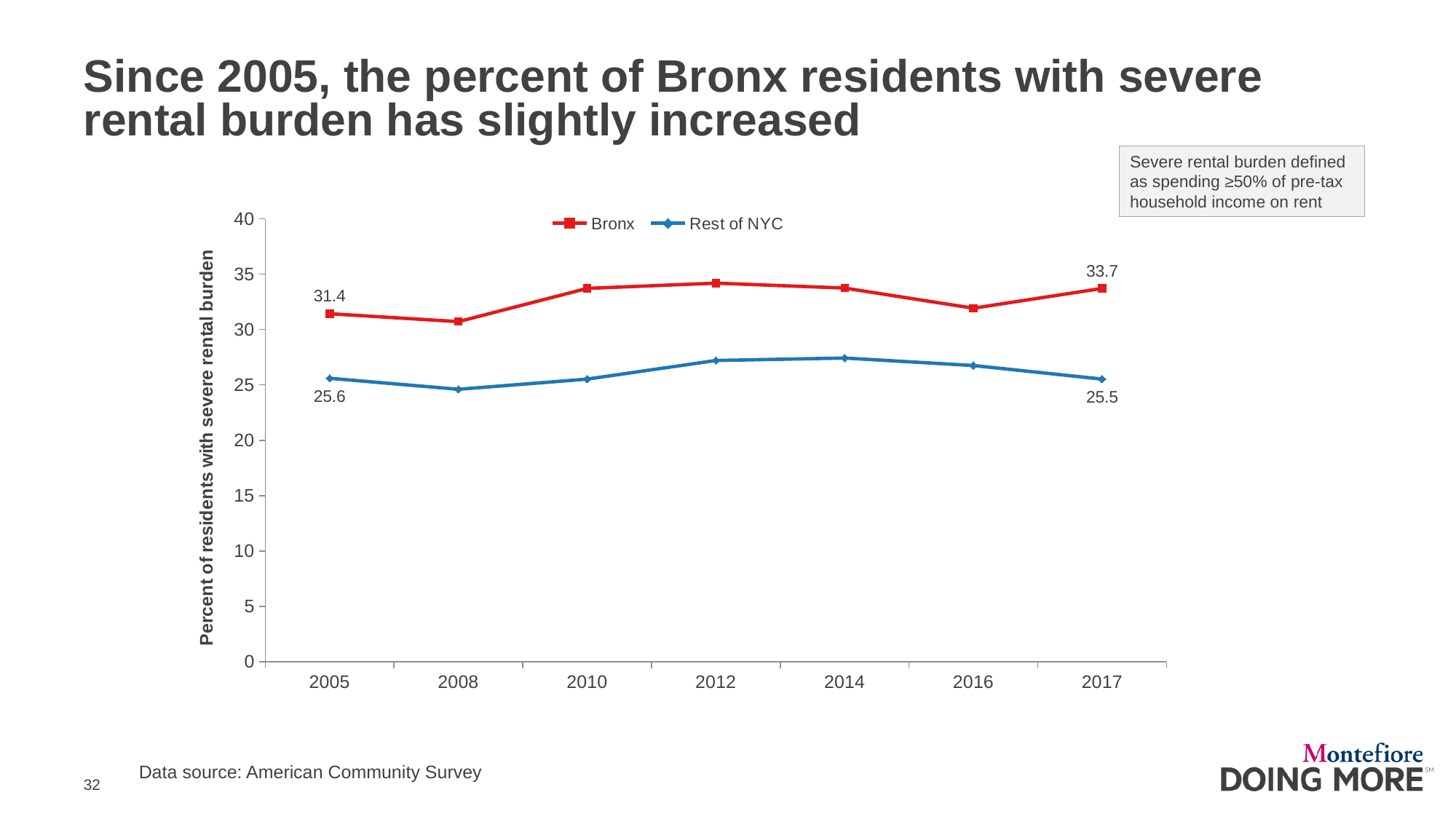
What is the difference between the Bronx and Rest of NYC values in 2017? 8.2 Which series has the higher value in 2012, Bronx or Rest of NYC? Bronx How many years are shown on the x axis? 7 What is the value for Bronx in 2017? 33.7 Which year has the higher Bronx value, 2005 or 2017? 2017 What is the value for Rest of NYC in 2017? 25.5 What is the value for Rest of NYC in 2005? 25.6 How many series does the legend list? 2 What kind of chart is shown on the slide? line chart By how much did the Bronx value change from 2005 to 2017? 2.3 What is the value for Bronx in 2005? 31.4 Is the value for Bronx in 2008 greater or less than 35? less